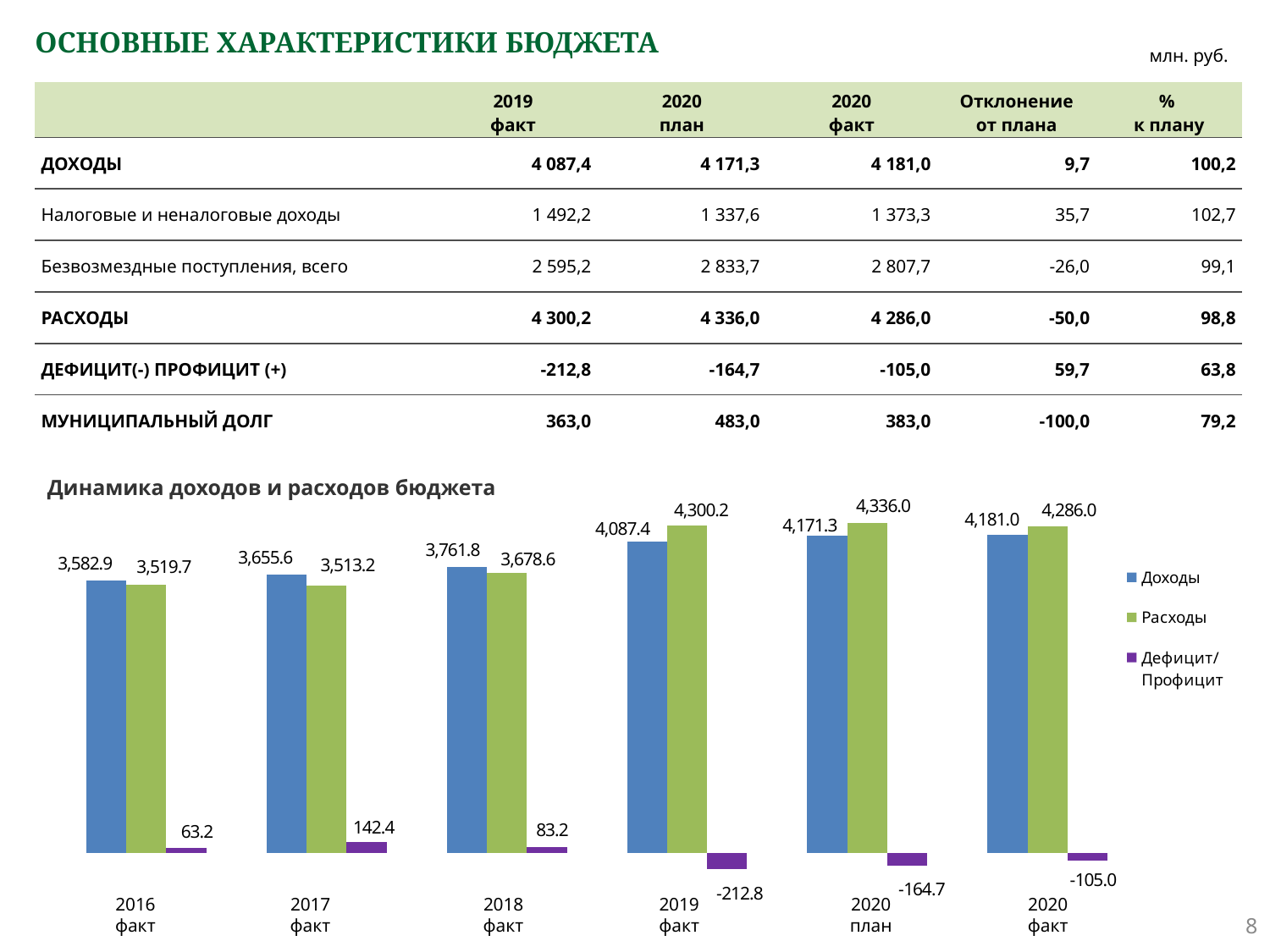
Which is larger for 2018 факт in the chart: Доходы or Расходы? Доходы What is the difference between Расходы and Доходы for 2020 факт in the chart? 105.0 Do the Доходы values rise or fall from 2016 факт to 2020 факт in the chart? Rise What type of chart is shown on the slide? Bar chart What is the value of Расходы for 2019 факт in the chart? 4,300.2 Which category has the lowest Доходы value in the chart? 2016 факт Which category has the highest Расходы value in the chart? 2020 план What is the value of Доходы for 2016 факт in the chart? 3,582.9 How many categories are shown on the x axis of the chart? 6 What is the Дефицит/Профицит value for 2017 факт in the chart? 142.4 How many series does the chart legend list? 3 What is the Дефицит/Профицит value for 2020 план in the chart? -164.7